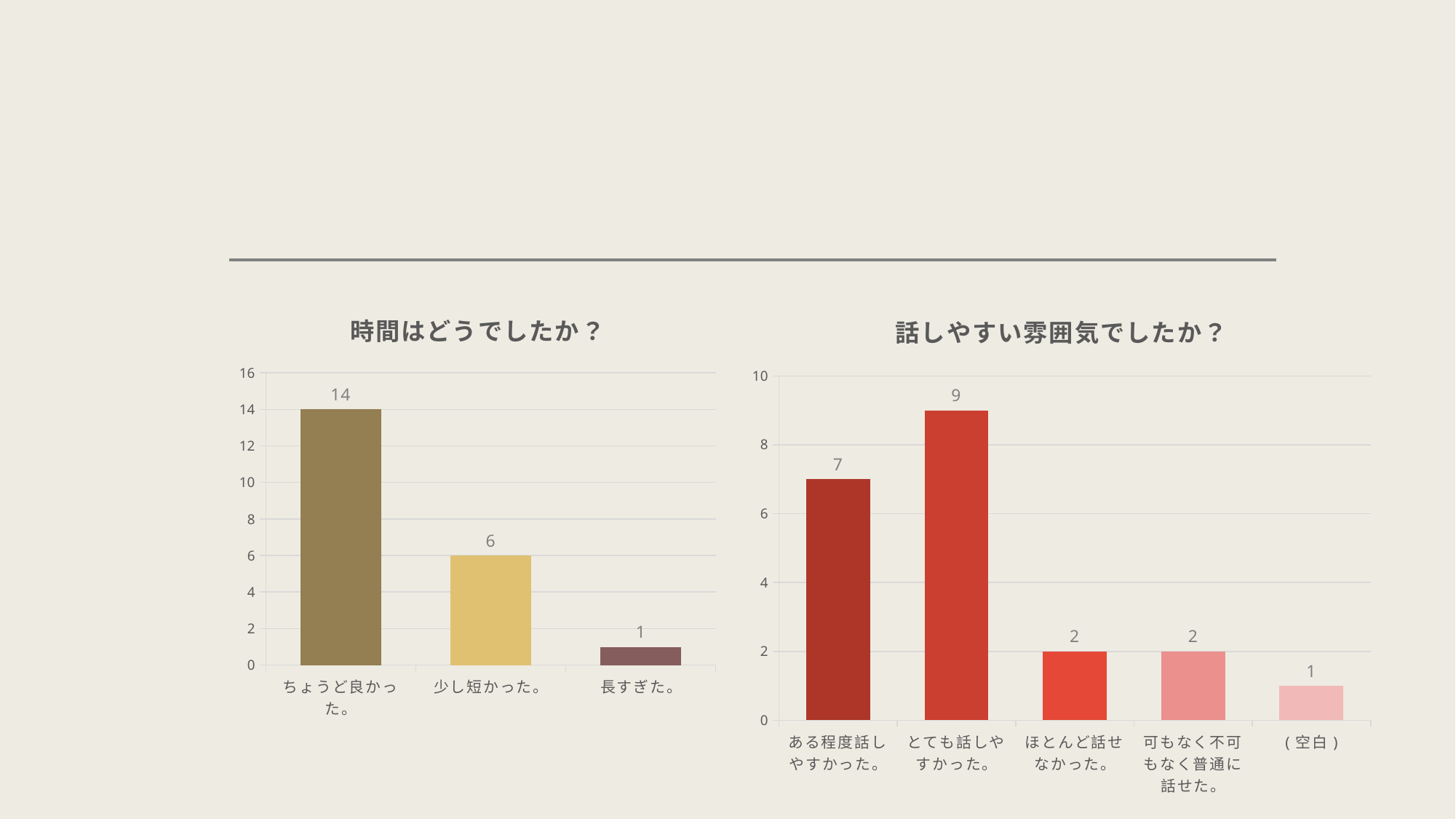
In the chart titled 話しやすい雰囲気でしたか？, which category has the highest value? とても話しやすかった。 In the chart titled 話しやすい雰囲気でしたか？, what is the value for ある程度話しやすかった。? 7 In the chart titled 時間はどうでしたか？, how many categories are shown? 3 In the chart titled 話しやすい雰囲気でしたか？, how many categories are shown? 5 In the chart titled 話しやすい雰囲気でしたか？, what is the value for とても話しやすかった。? 9 In the chart titled 時間はどうでしたか？, what is the value for ちょうど良かった。? 14 In the chart titled 時間はどうでしたか？, what is the value for 少し短かった。? 6 In the chart titled 話しやすい雰囲気でしたか？, which is larger: ある程度話しやすかった。 or ほとんど話せなかった。? ある程度話しやすかった。 What kind of chart is the chart on the left of the slide? bar chart In the chart titled 時間はどうでしたか？, what is the difference between ちょうど良かった。 and 少し短かった。? 8 In the chart titled 時間はどうでしたか？, which category has the lowest value? 長すぎた。 In the chart titled 話しやすい雰囲気でしたか？, what is the value for (空白)? 1